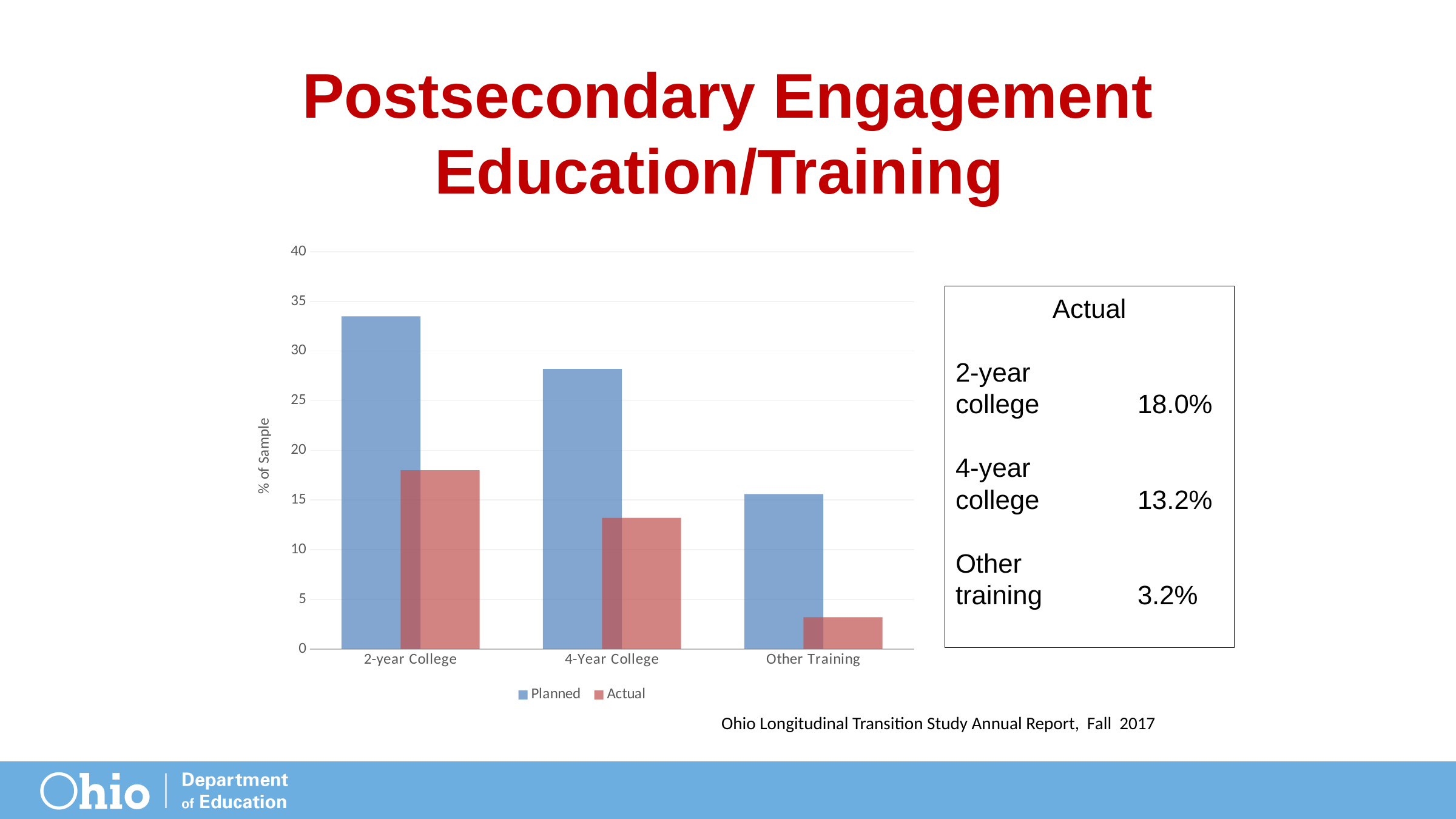
How many series does the chart's legend list? 2 What is the Actual value for Other training? 3.2% What is the difference between the Actual values for 2-year college and 4-year college? 4.8% Which category has the highest Planned value? 2-year College What is the Actual value for 2-year college? 18.0% What is the Actual value for 4-year college? 13.2% Is the Planned value for Other Training greater or less than 20? less How many categories are shown on the x axis of the chart? 3 What kind of chart is shown on the slide? bar chart For 4-Year College, which is larger, the Planned value or the Actual value? Planned Which category has the lowest Actual value? Other training Is the Planned value for 2-year College greater or less than 30? greater